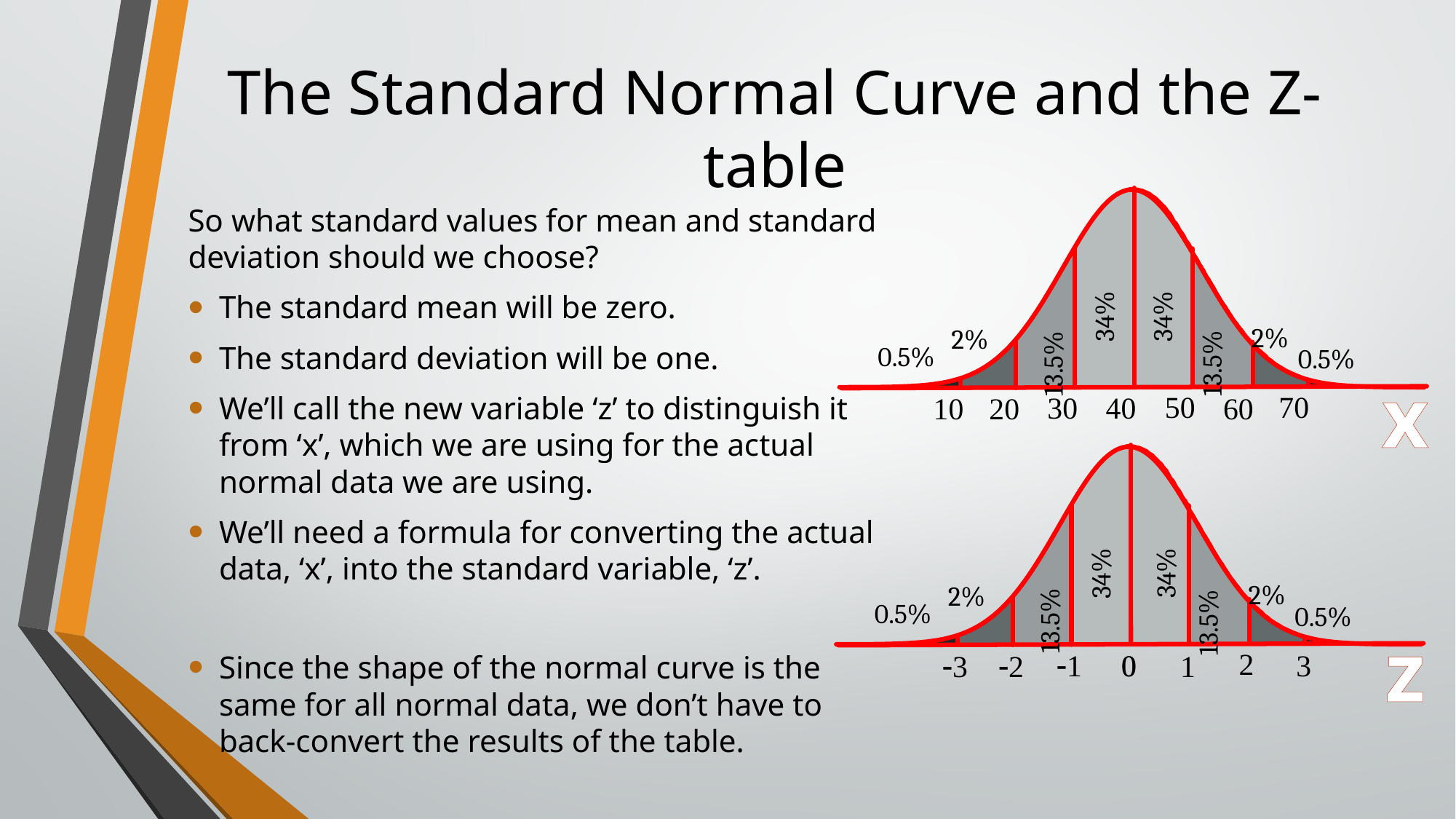
On the top chart (X axis), what percentage is labelled in the region between 20 and 30? 13.5% What letter labels the horizontal axis of the bottom chart? Z On the bottom chart (Z axis), what is the difference between the 34% region and the 13.5% region? 20.5% On the top chart (X axis), what is the smallest percentage labelled on the curve? 0.5% On the top chart (X axis), what percentage is labelled in the region between 10 and 20? 2% What kind of chart is shown on the slide? Normal (bell) curve On the bottom chart (Z axis), what is the total percentage labelled between -1 and 1? 68% On the top chart (X axis), what is the total percentage labelled between 20 and 60? 95% On the top chart (X axis), what percentage is labelled in the region between 30 and 40? 34% On the bottom chart (Z axis), what percentage is labelled in the region between 1 and 2? 13.5% On the bottom chart (Z axis), what percentage is labelled in the tail beyond 3? 0.5% On the bottom chart (Z axis), how many tick values are printed along the horizontal axis? 7